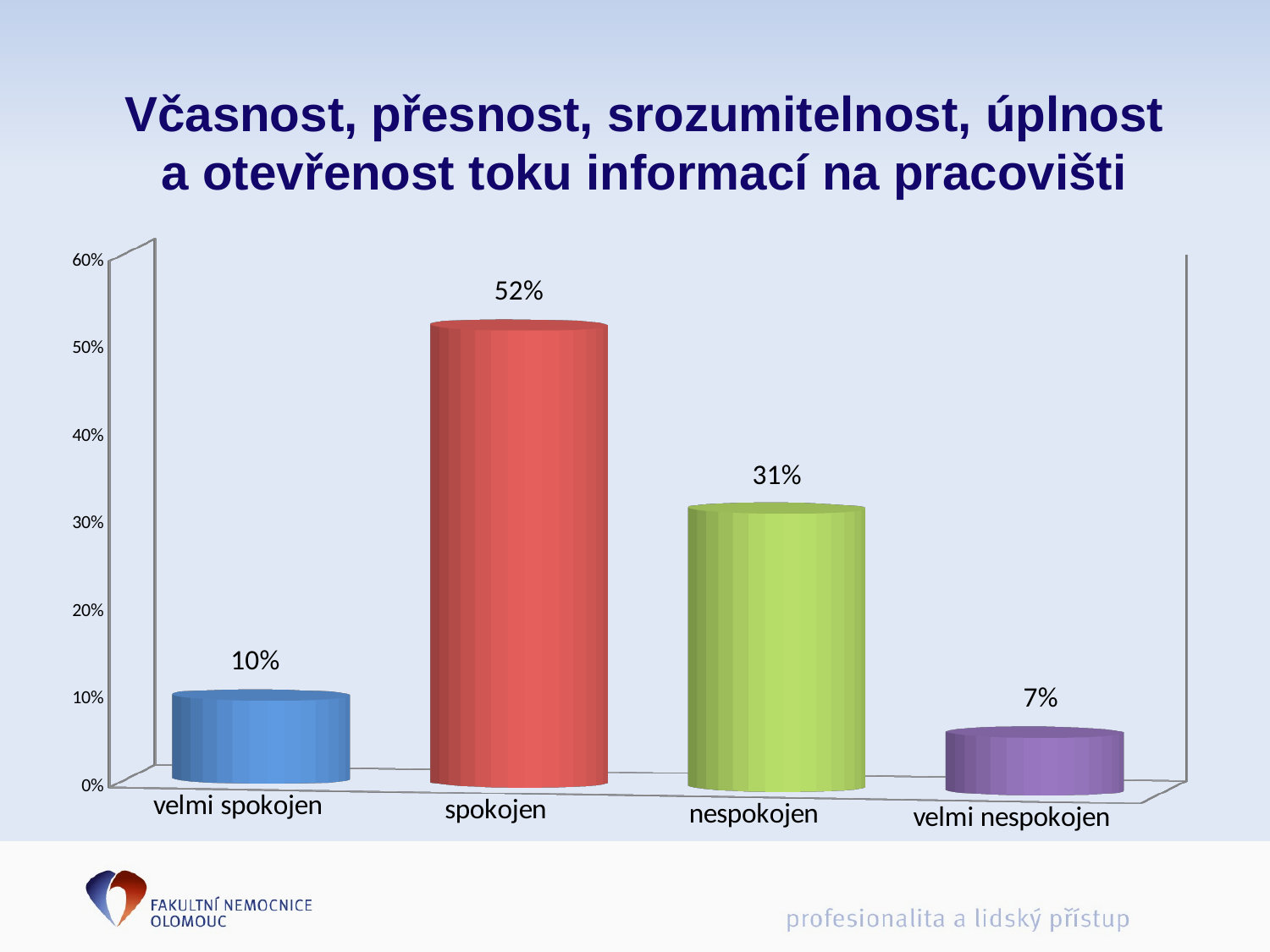
What is the value for "spokojen"? 52% What colour is the bar for "spokojen"? red What is the value for "velmi nespokojen"? 7% Which category has the lowest value? velmi nespokojen What is the difference between the values for "spokojen" and "nespokojen"? 21% What kind of chart is shown on the slide? bar chart Which category has the highest value? spokojen What is the value for "velmi spokojen"? 10% What is the value for "nespokojen"? 31% How many categories are shown on the x axis? 4 Is the value for "nespokojen" greater or less than 40%? less Which is larger, the value for "velmi spokojen" or the value for "velmi nespokojen"? velmi spokojen